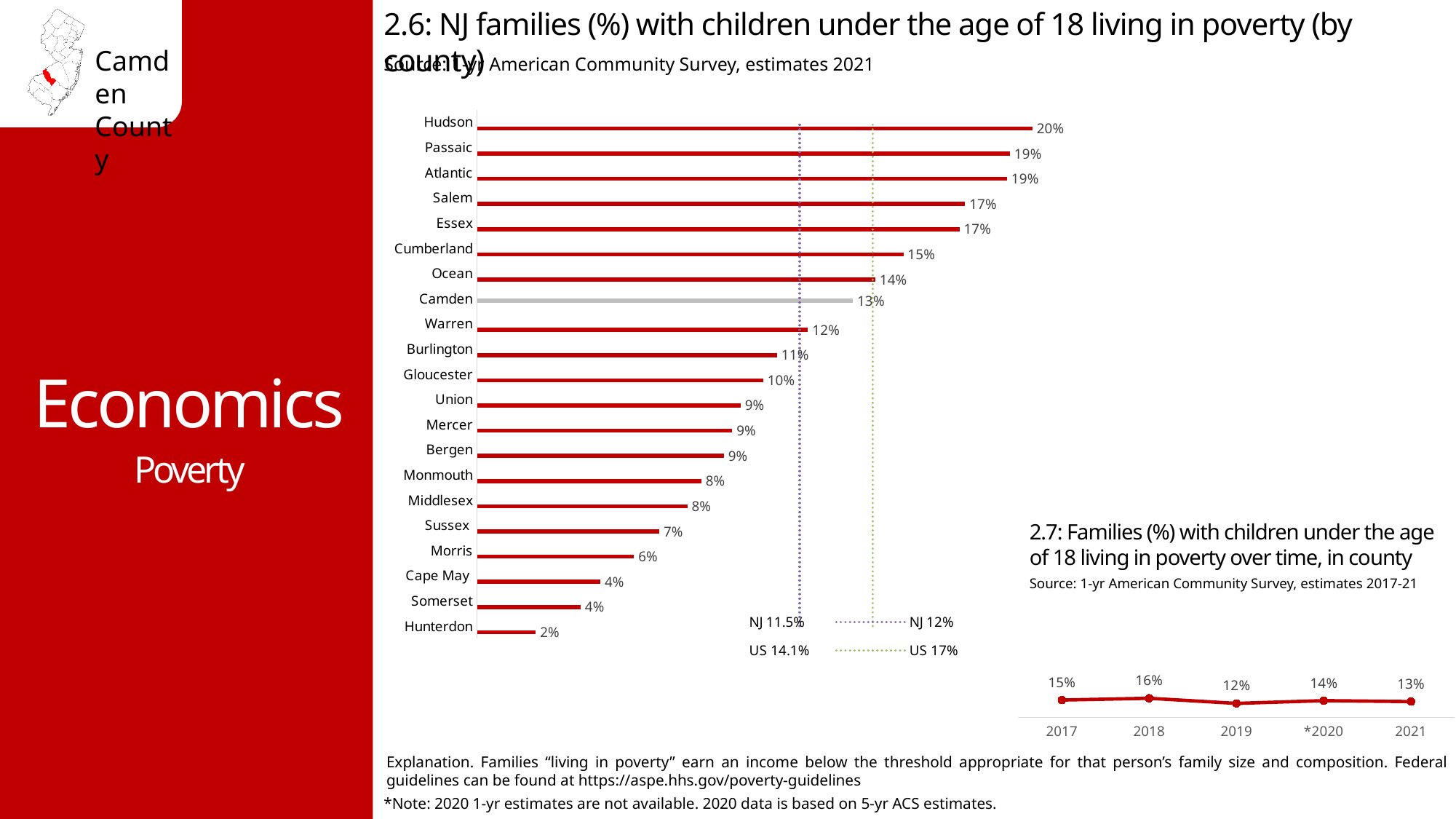
What kind of chart is chart 2.6? Bar chart In chart 2.7, what is the value for 2018? 16% In chart 2.6, what is the value for Cumberland? 15% In chart 2.6, how many counties are plotted? 21 In chart 2.6, which county has the lowest value? Hunterdon In chart 2.6, what is the difference between the values for Hudson and Camden? 7% In chart 2.7, which year has the lowest value? 2019 In chart 2.6, what is the value for Camden? 13% In chart 2.6, which has a larger value, Ocean or Warren? Ocean In chart 2.6, which county has the highest value? Hudson In chart 2.7, what is the difference between the values for 2018 and 2021? 3%